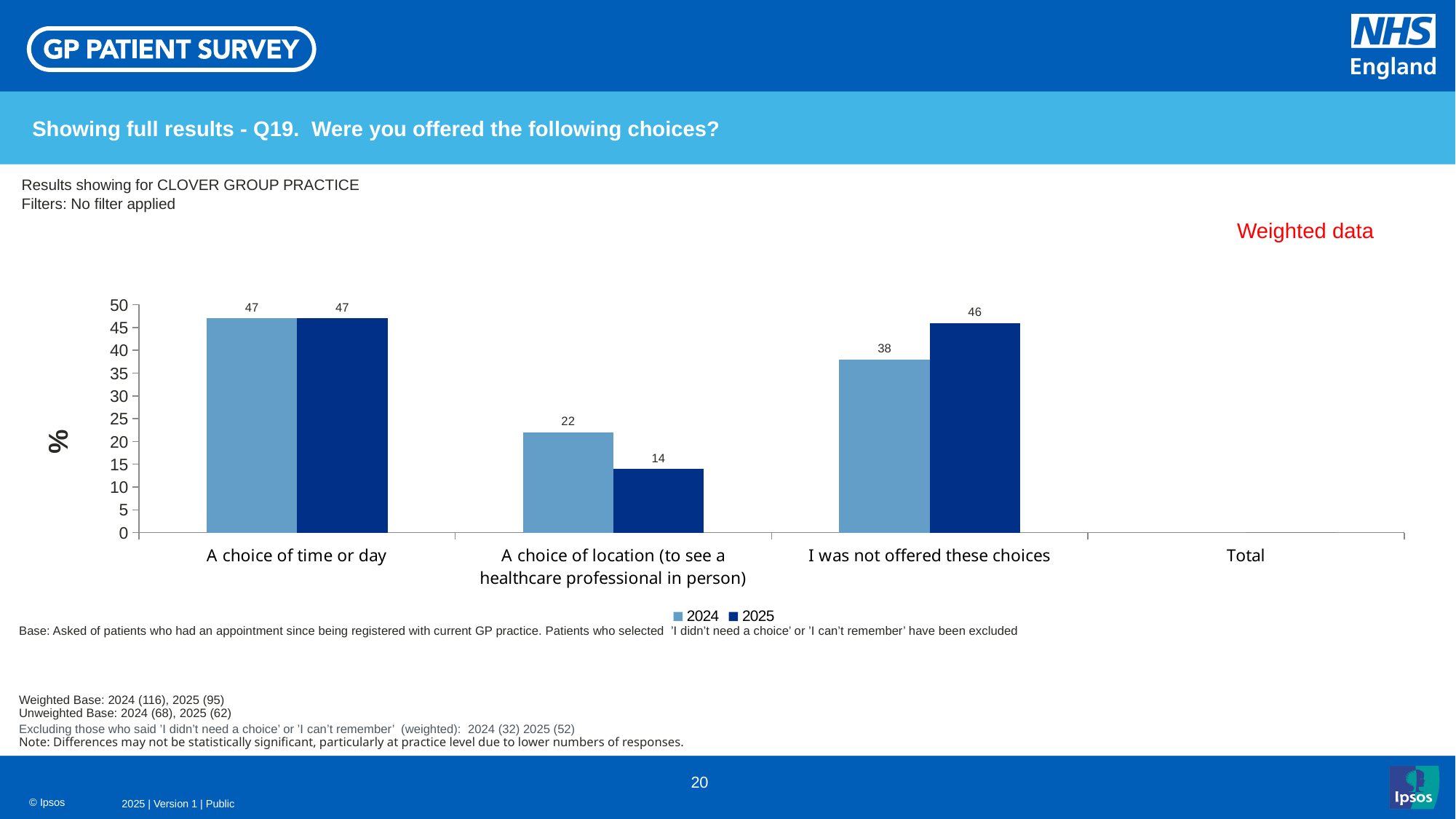
What is the 2024 value for 'A choice of time or day'? 47 Is the 2024 value for 'A choice of location (to see a healthcare professional in person)' greater or less than 20? greater How many series does the legend list? 2 What is the difference between the 2024 and 2025 values for 'A choice of location (to see a healthcare professional in person)'? 8 For 'I was not offered these choices', which year has the larger value, 2024 or 2025? 2025 Which category has the highest 2024 value? A choice of time or day What is the 2025 value for 'A choice of location (to see a healthcare professional in person)'? 14 What is the difference between the 2025 and 2024 values for 'I was not offered these choices'? 8 Which category has the lowest 2025 value? A choice of location (to see a healthcare professional in person) What is the 2025 value for 'I was not offered these choices'? 46 What kind of chart is shown on the slide? Bar chart What is the 2024 value for 'I was not offered these choices'? 38